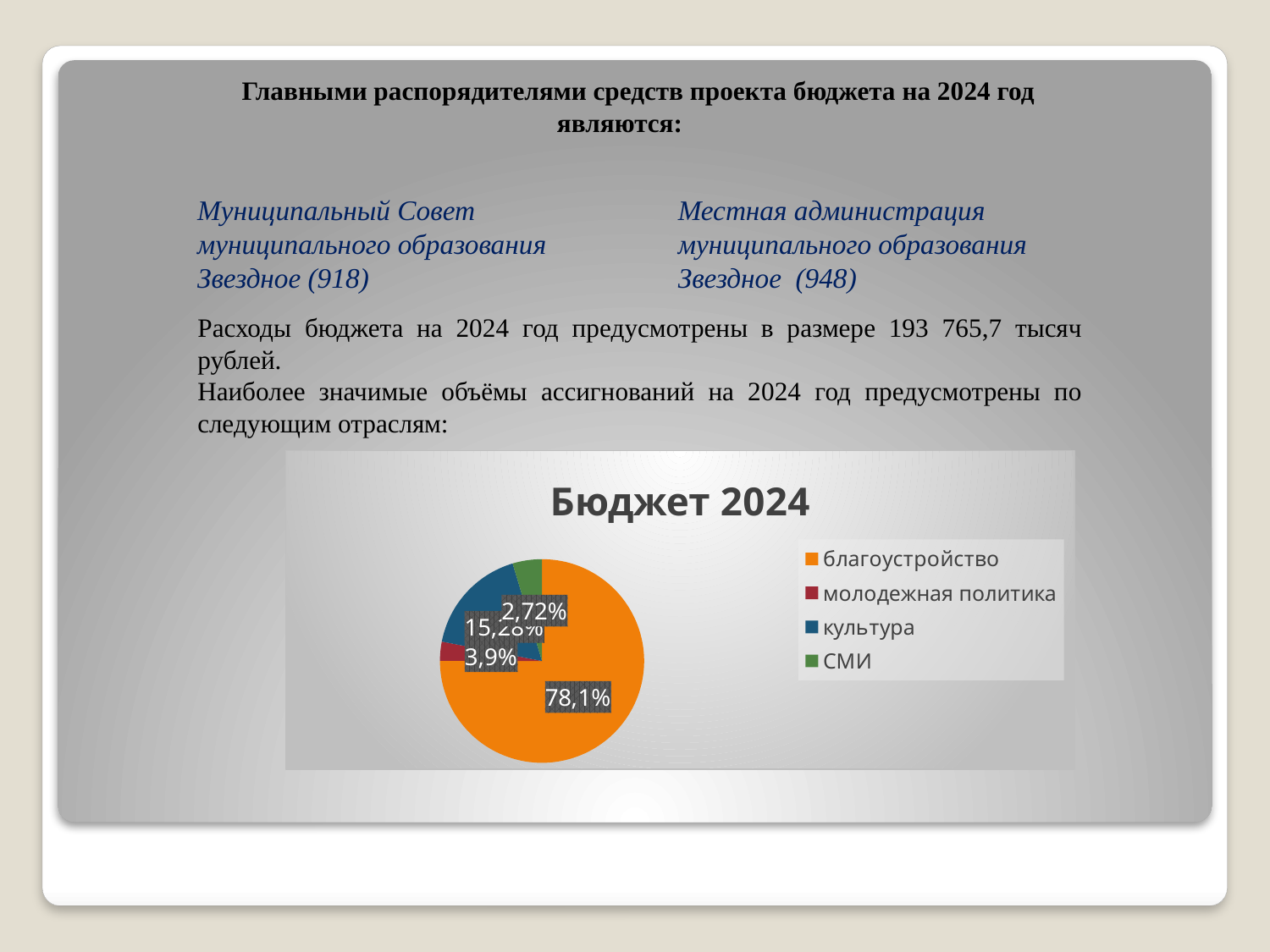
Which is larger, the slice for культура or the slice for благоустройство? благоустройство What is the difference between the share for благоустройство and the share for молодежная политика? 74,2% What is the title of the chart? Бюджет 2024 How many categories does the legend of the chart list? 4 What share of the pie does молодежная политика have? 3,9% What colour is the slice for благоустройство? orange What share of the pie does СМИ have? 2,72% Which category has the largest slice of the pie? благоустройство What share of the pie does благоустройство have? 78,1% What kind of chart is shown on the slide? pie chart